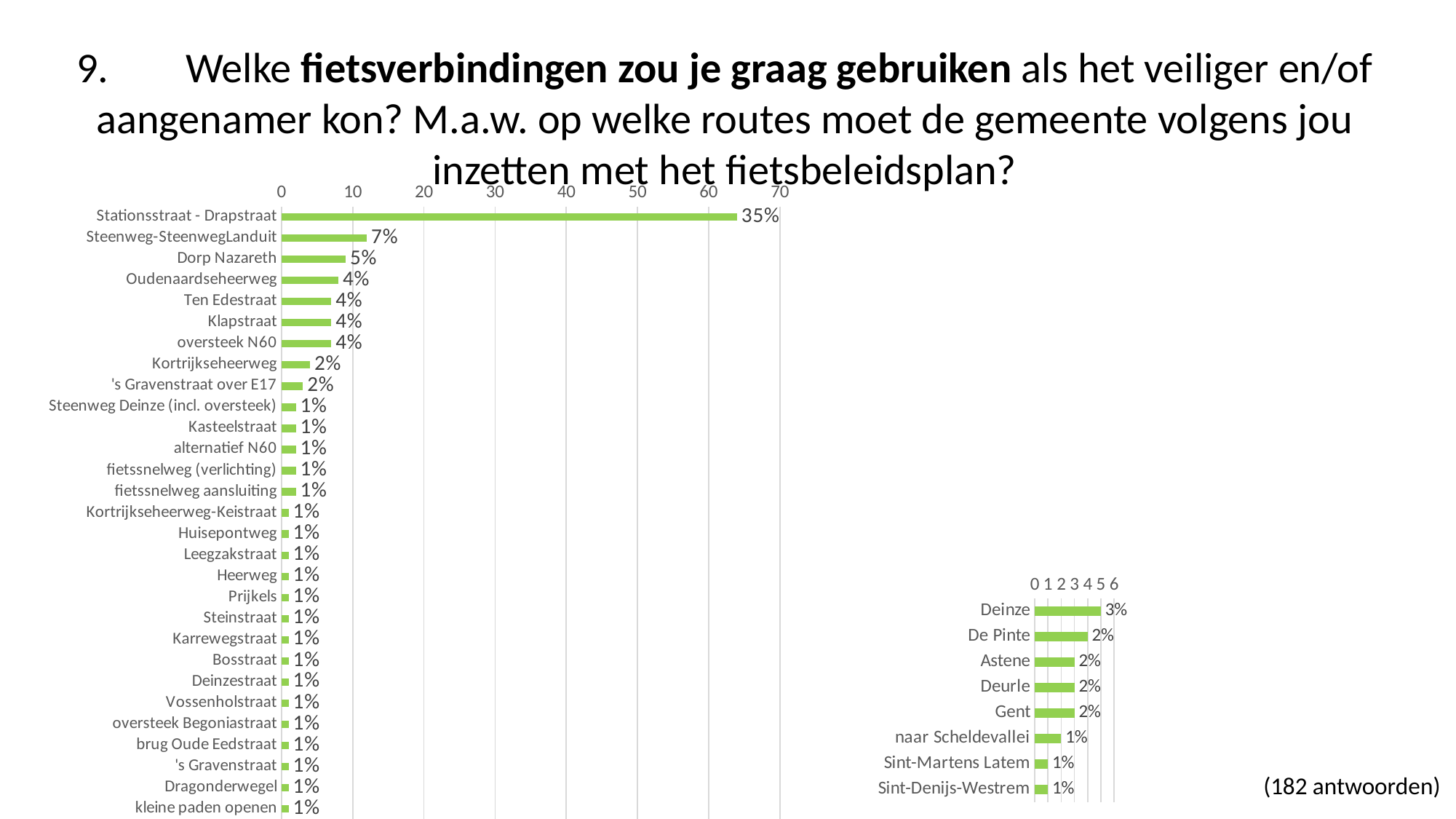
In the left chart, what is the value shown for Stationsstraat - Drapstraat? 35% How many categories are shown in the right chart? 8 What kind of chart is the left chart? bar chart In the left chart, what is the value shown for Dorp Nazareth? 5% In the left chart, which category has the highest value? Stationsstraat - Drapstraat How many categories are shown in the left chart? 29 In the left chart, what is the difference between the values for Stationsstraat - Drapstraat and Steenweg-SteenwegLanduit? 28% In the right chart, what is the value shown for Deinze? 3% In the right chart, which category has the highest value? Deinze In the right chart, what is the difference between the values for Deinze and Sint-Denijs-Westrem? 2% In the left chart, is the bar for Stationsstraat - Drapstraat greater or less than 60 on the axis? greater In the left chart, which is larger: the value for Steenweg-SteenwegLanduit or the value for Kortrijkseheerweg? Steenweg-SteenwegLanduit